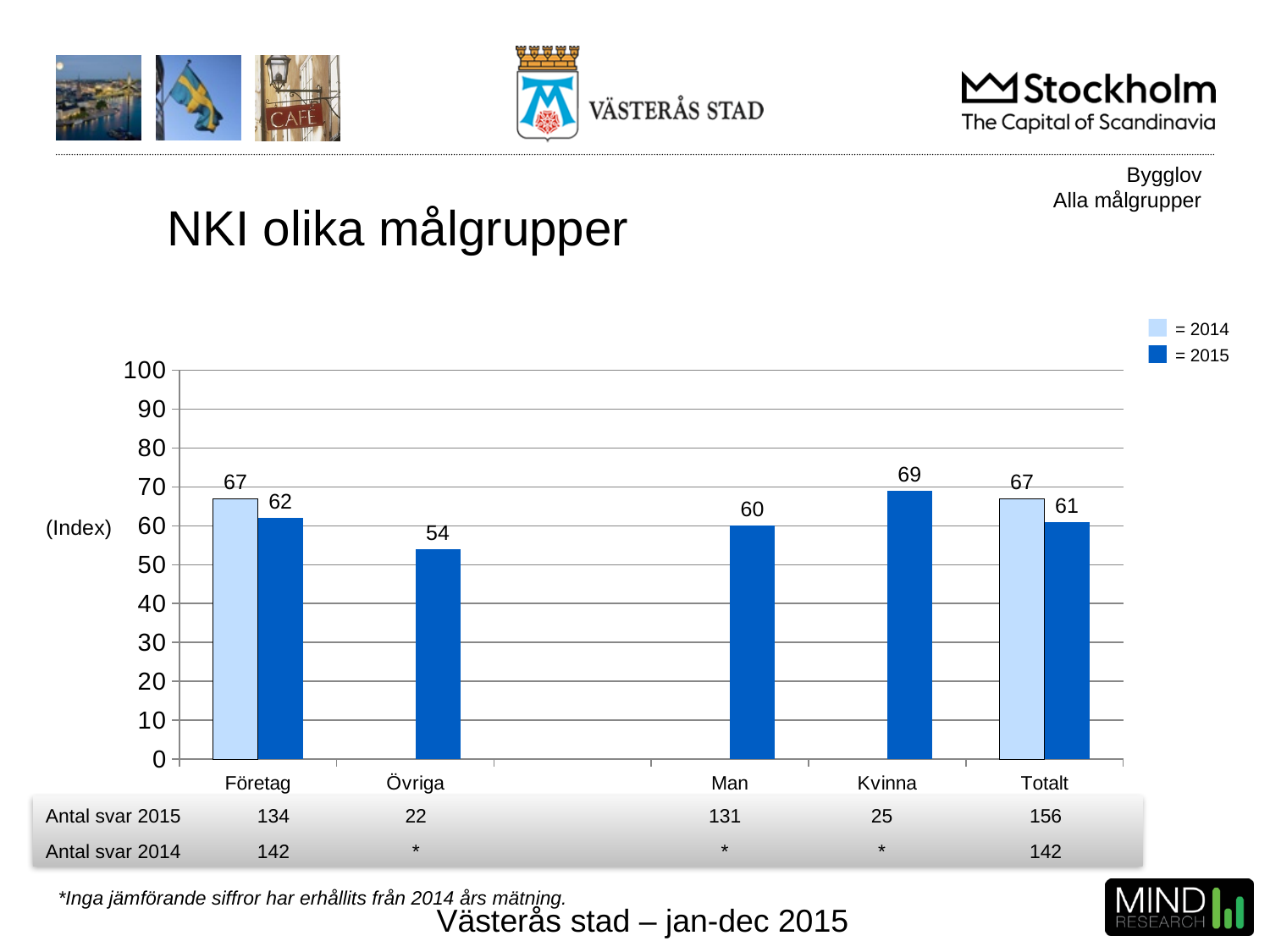
What is the 2015 NKI value for Företag? 62 Which category has the highest 2015 NKI value? Kvinna What is the 2014 NKI value for Totalt? 67 What is the 2015 NKI value for Kvinna? 69 How many series does the legend list? 2 What kind of chart is shown on the slide? Bar chart What is the difference between the 2014 and 2015 NKI values for Företag? 5 What is the difference between the 2015 NKI values for Kvinna and Man? 9 Which is larger, the 2015 NKI value for Man or for Övriga? Man Which category has the lowest 2015 NKI value? Övriga How many categories are shown on the x axis of the chart? 5 What is the title of the chart? NKI olika målgrupper